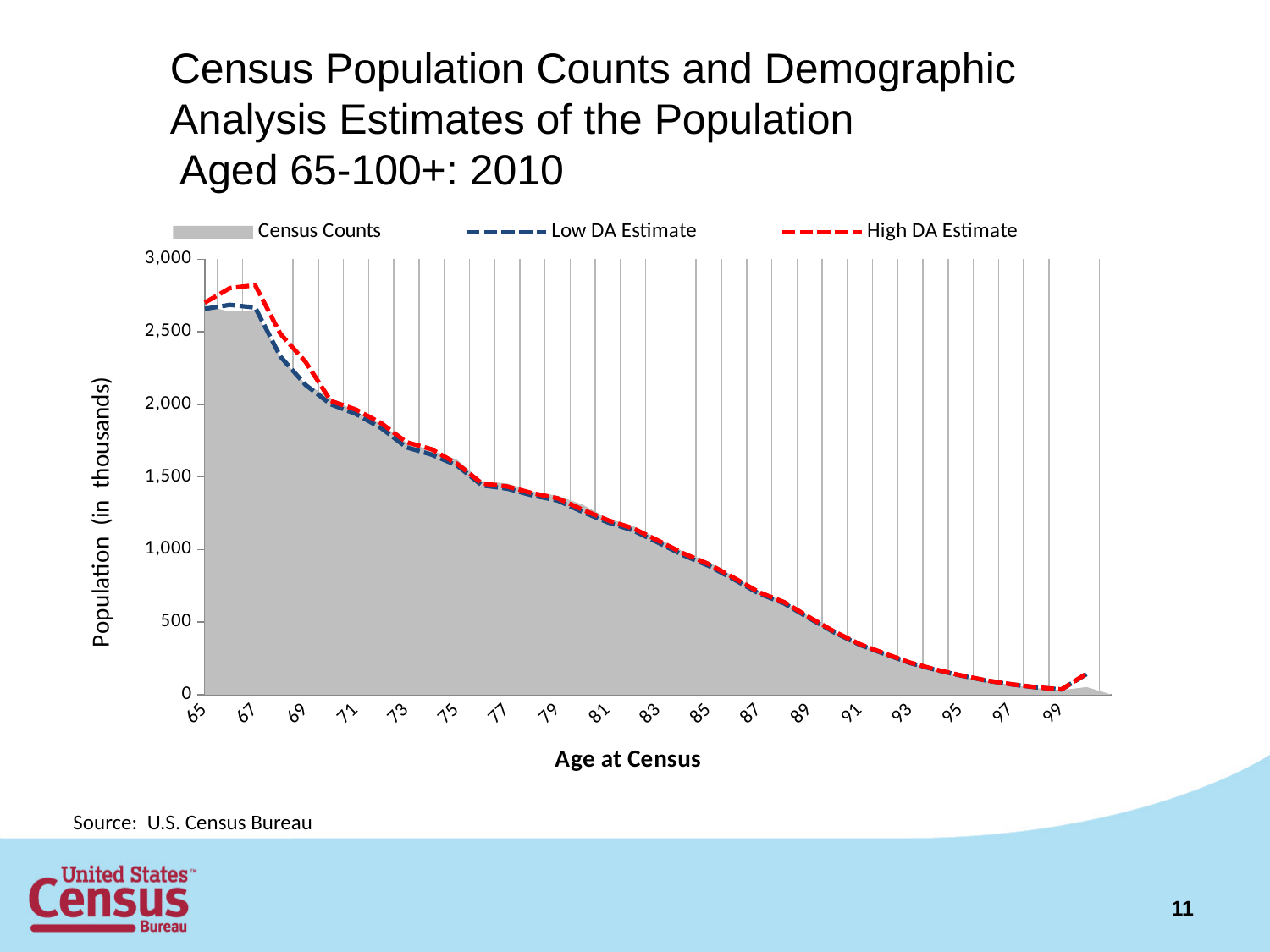
Is the Census Counts value at age 73 greater or less than 1,500? greater How many series does the legend list? 3 Is the High DA Estimate at age 67 greater or less than 2,500? greater At which age does the High DA Estimate reach its highest value? 67 Is the High DA Estimate at age 91 greater or less than 500? less What are the three series named in the legend? Census Counts, Low DA Estimate, High DA Estimate What is the label of the x axis? Age at Census Do the Census Counts rise or fall as age increases from 65 to 99? fall What kind of chart is used to draw the Low DA Estimate and High DA Estimate series? line chart At age 67, which is larger, the High DA Estimate or the Low DA Estimate? High DA Estimate